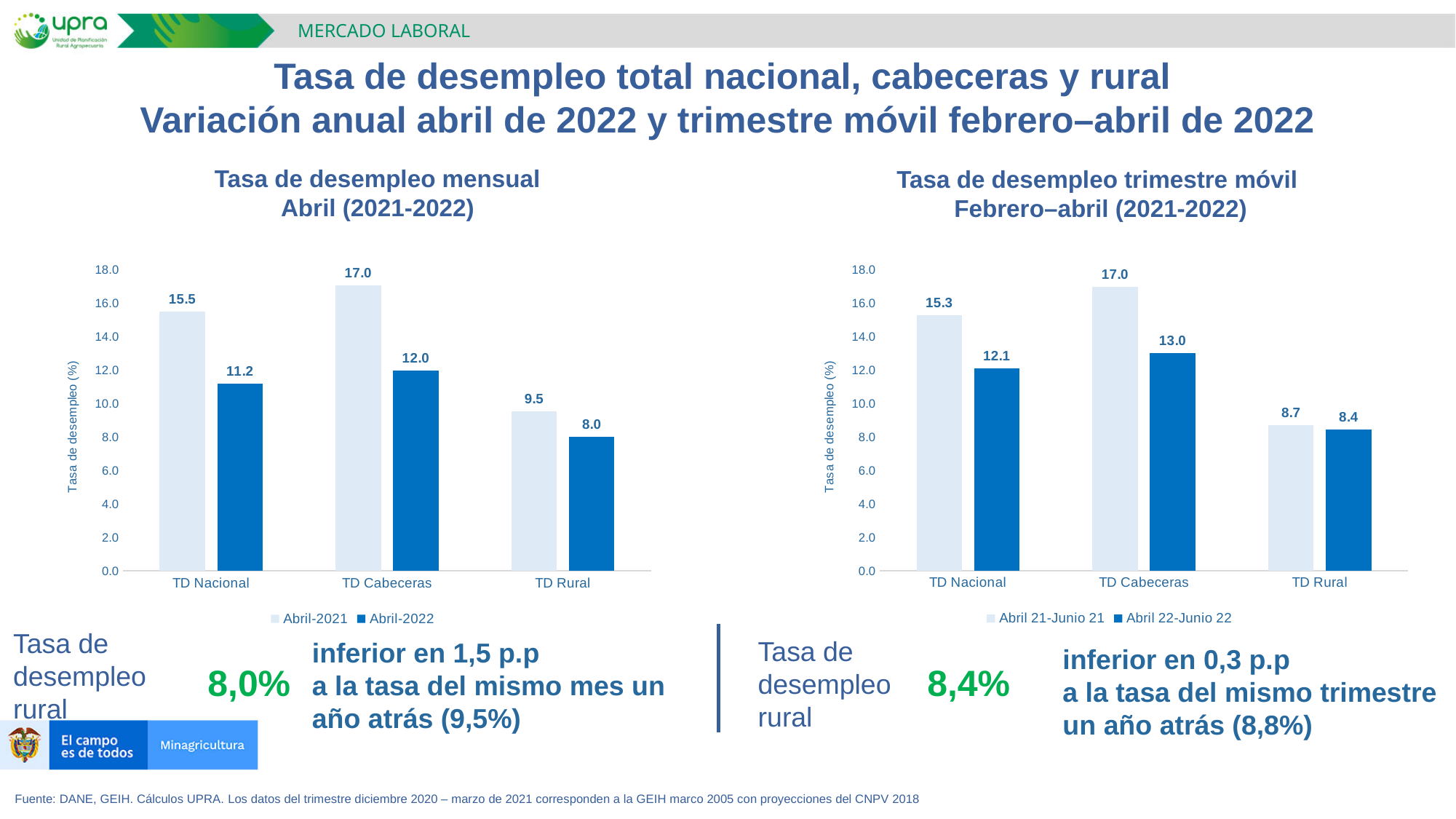
In the right chart (Tasa de desempleo trimestre móvil Febrero–abril), what is the value for TD Cabeceras in Abril 22-Junio 22? 13.0 In the right chart (Tasa de desempleo trimestre móvil Febrero–abril), what is the value for TD Rural in Abril 21-Junio 21? 8.7 In the left chart (Tasa de desempleo mensual Abril), what kind of chart is shown? Bar chart In the right chart (Tasa de desempleo trimestre móvil Febrero–abril), how many categories are shown on the x axis? 3 In the left chart (Tasa de desempleo mensual Abril), what is the value for TD Rural in Abril-2021? 9.5 In the right chart (Tasa de desempleo trimestre móvil Febrero–abril), which is larger: the TD Nacional value for Abril 22-Junio 22 or the TD Rural value for Abril 21-Junio 21? TD Nacional value for Abril 22-Junio 22 In the left chart (Tasa de desempleo mensual Abril), what is the value for TD Nacional in Abril-2022? 11.2 In the left chart (Tasa de desempleo mensual Abril), what is the difference between the Abril-2021 and Abril-2022 values for TD Nacional? 4.3 In the left chart (Tasa de desempleo mensual Abril), how many series does the legend list? 2 In the right chart (Tasa de desempleo trimestre móvil Febrero–abril), what is the difference between the Abril 21-Junio 21 and Abril 22-Junio 22 values for TD Cabeceras? 4.0 In the right chart (Tasa de desempleo trimestre móvil Febrero–abril), which category has the lowest Abril 22-Junio 22 value? TD Rural In the left chart (Tasa de desempleo mensual Abril), which category has the highest Abril-2021 value? TD Cabeceras